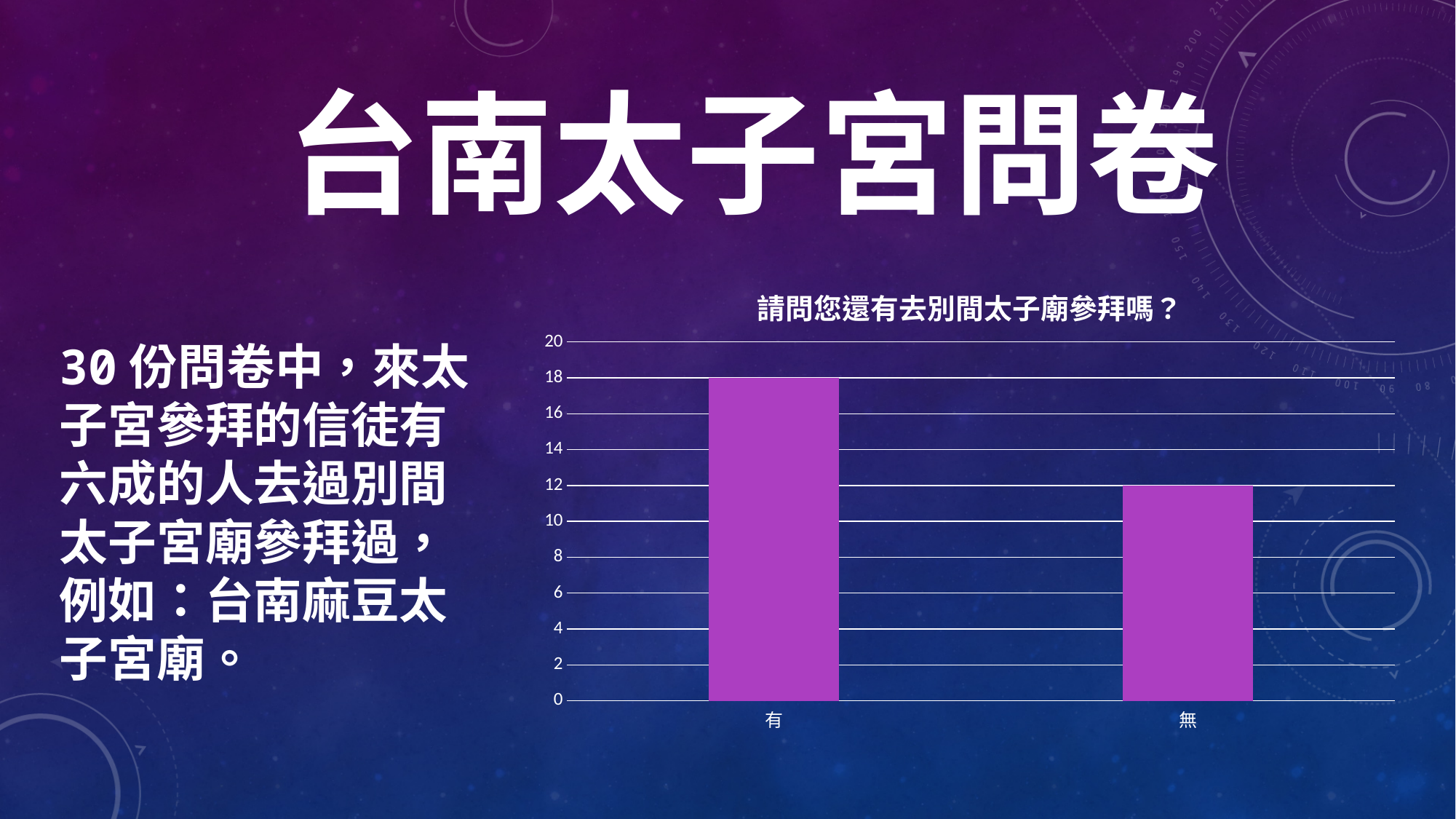
Which is larger, the value for 有 or the value for 無? 有 What is the value for 無? 12 Which category has the highest value? 有 Is the value for 無 greater or less than 14? less What is the difference between the values for 有 and 無? 6 What is the maximum value shown on the y axis? 20 Which category has the lowest value? 無 What is the value for 有? 18 How many categories are shown on the x axis? 2 Is the value for 有 greater or less than 16? greater What kind of chart is shown on the slide? bar chart What is the title of the chart? 請問您還有去別間太子廟參拜嗎？